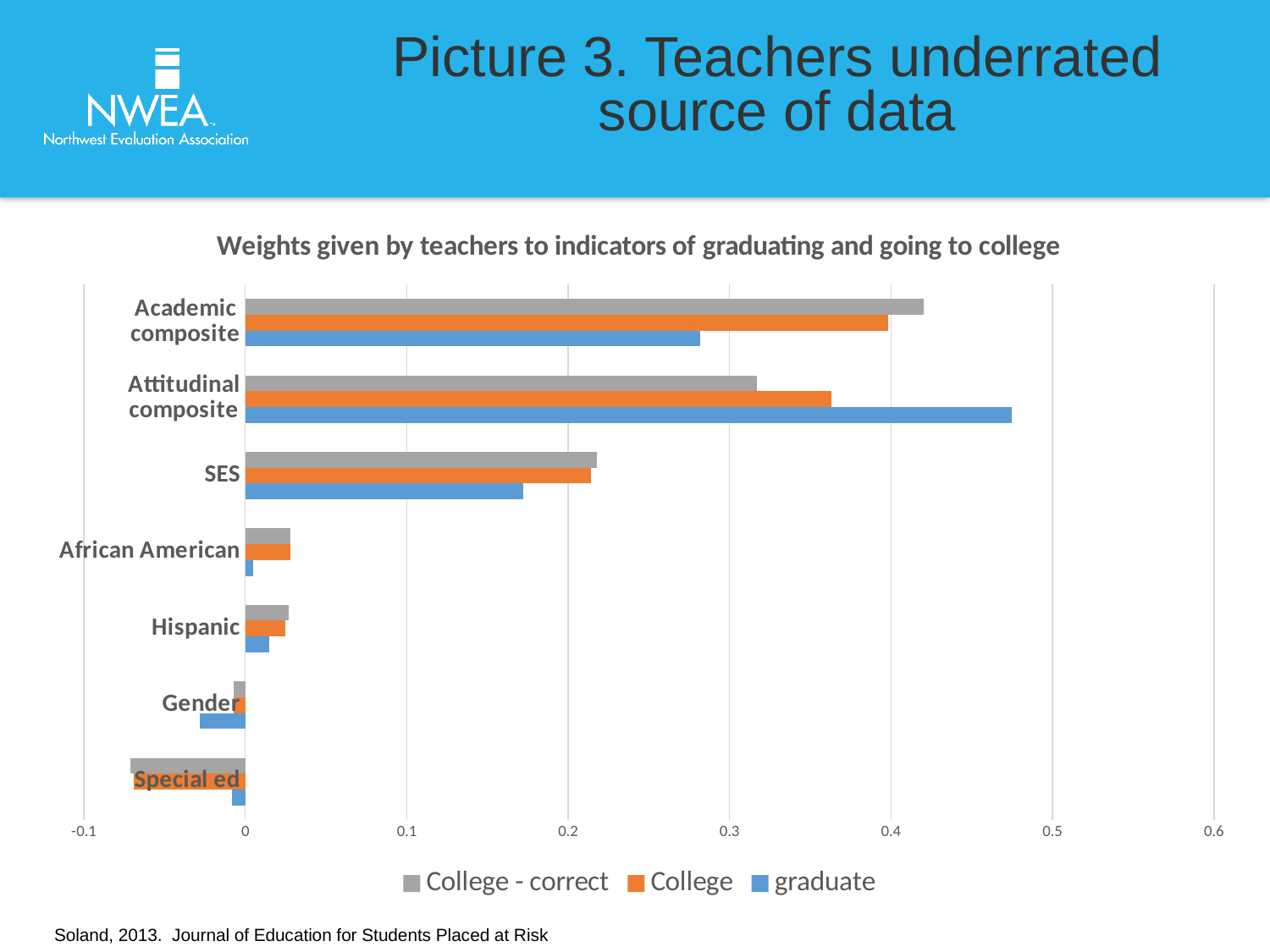
What is the title of the chart? Weights given by teachers to indicators of graduating and going to college Is the 'graduate' value for Academic composite greater or less than 0.3? less Which category has the lowest value for the 'graduate' series? Gender Which category has the lowest value for the 'College - correct' series? Special ed Is the 'graduate' value for Attitudinal composite greater or less than 0.4? greater Which category has the highest value for the 'graduate' series? Attitudinal composite For Academic composite, which is larger: the 'College - correct' value or the 'graduate' value? College - correct How many categories are shown on the vertical axis of the chart? 7 How many series does the chart's legend list? 3 Which category has the highest value for the 'College - correct' series? Academic composite For Attitudinal composite, which is larger: the 'graduate' value or the 'College' value? graduate What kind of chart is shown on the slide? Bar chart